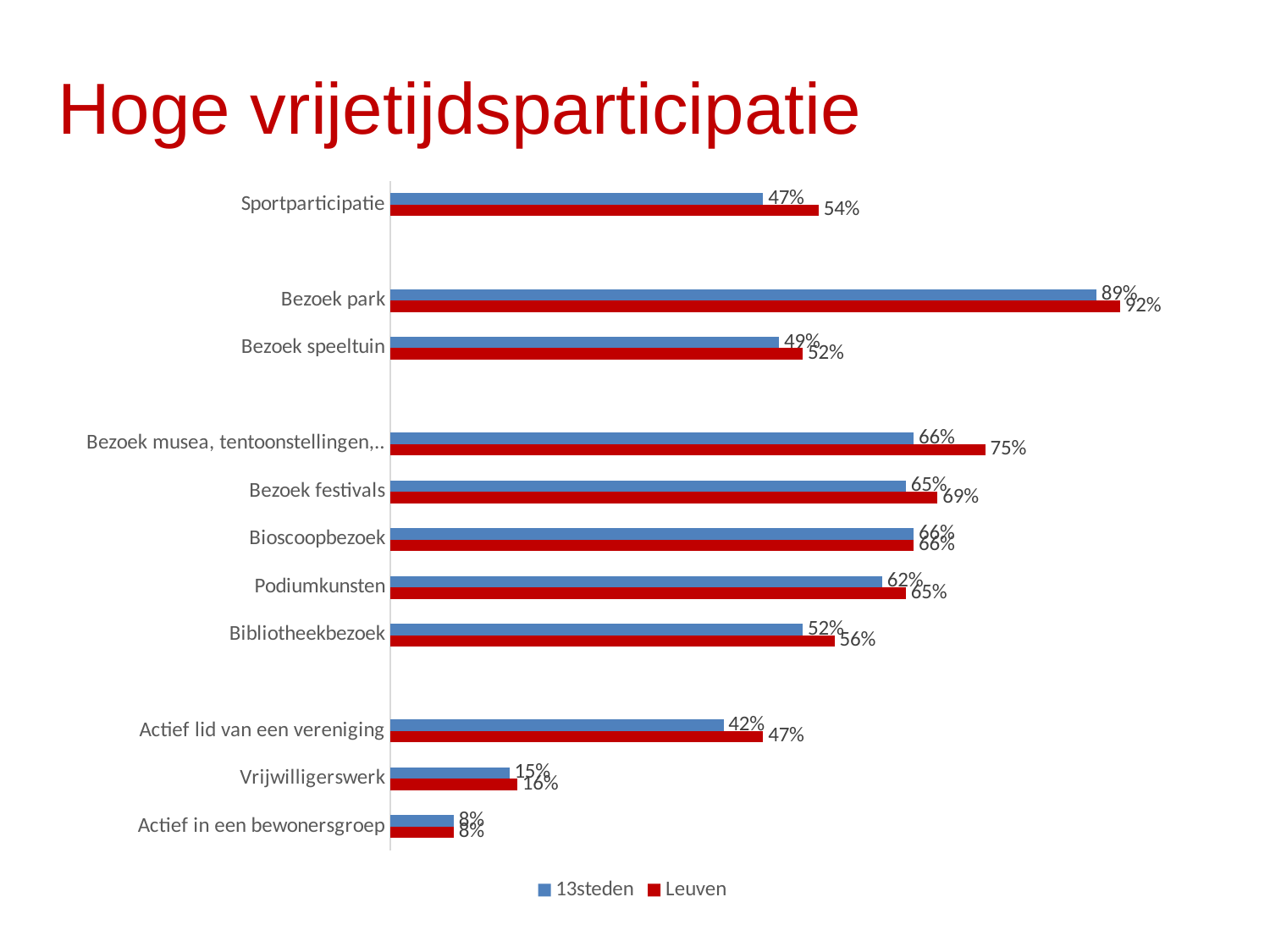
Which is larger for Actief lid van een vereniging: the 13steden value or the Leuven value? Leuven What is the Leuven value for Bezoek park? 92% Which category has the highest Leuven value? Bezoek park What is the difference between the Leuven and 13steden values for Bezoek musea, tentoonstellingen,..? 9% Which category has the lowest 13steden value? Actief in een bewonersgroep Which series is shown in red? Leuven How many categories are shown on the chart? 11 What is the Leuven value for Bezoek musea, tentoonstellingen,..? 75% How many series does the legend list? 2 What is the 13steden value for Vrijwilligerswerk? 15% What kind of chart is shown on the slide? Bar chart What is the 13steden value for Sportparticipatie? 47%